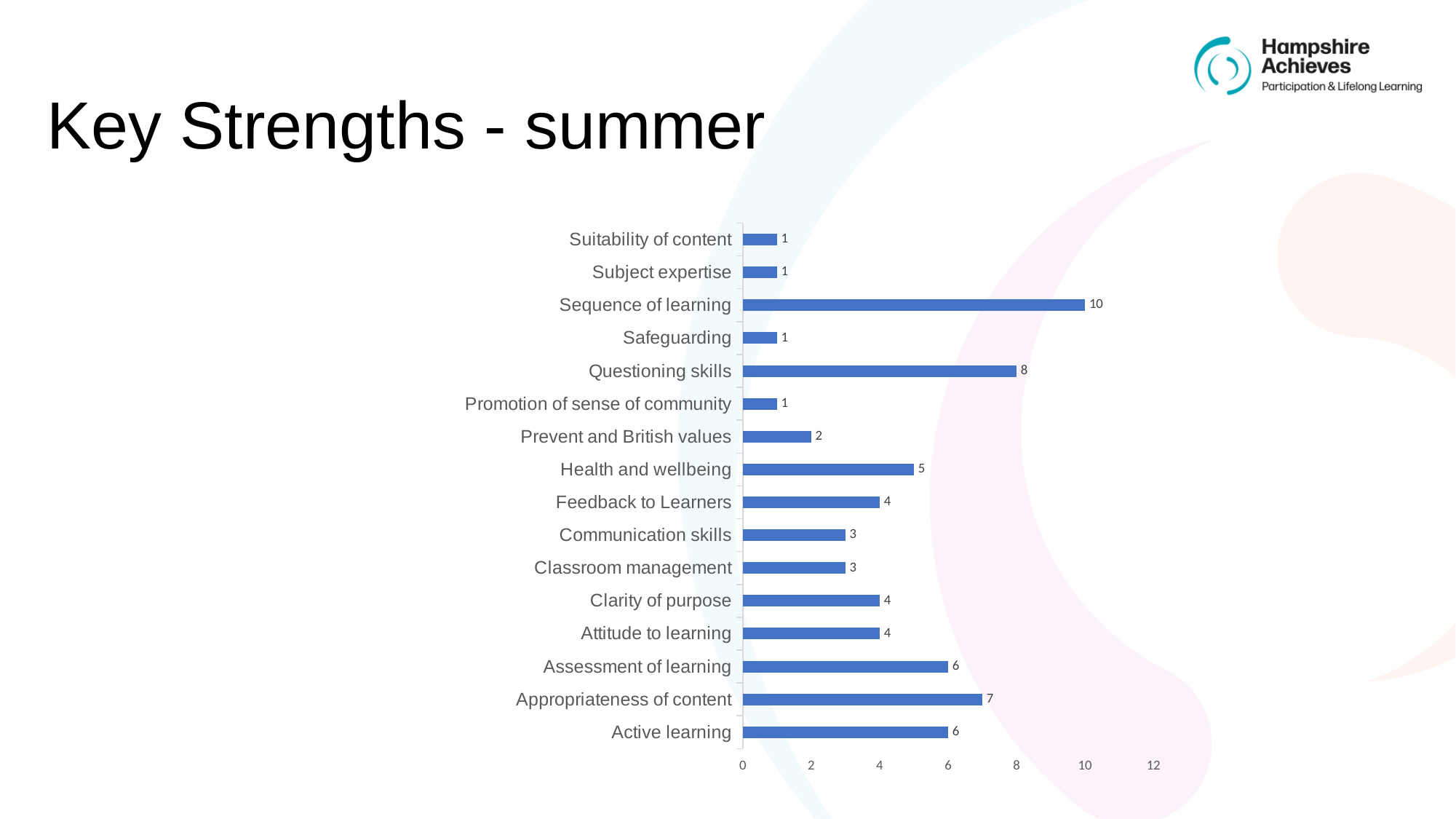
What kind of chart is shown on the slide? Bar chart What is the difference between the values for Appropriateness of content and Prevent and British values? 5 What is the value for Sequence of learning? 10 What is the title of the slide containing the chart? Key Strengths - summer How many categories are shown in the chart? 16 What is the difference between the values for Sequence of learning and Questioning skills? 2 What is the value for Health and wellbeing? 5 Which category has the highest value? Sequence of learning How many categories have a value of 1? 4 What is the value for Appropriateness of content? 7 What is the value for Questioning skills? 8 Which is larger, the value for Assessment of learning or the value for Feedback to Learners? Assessment of learning